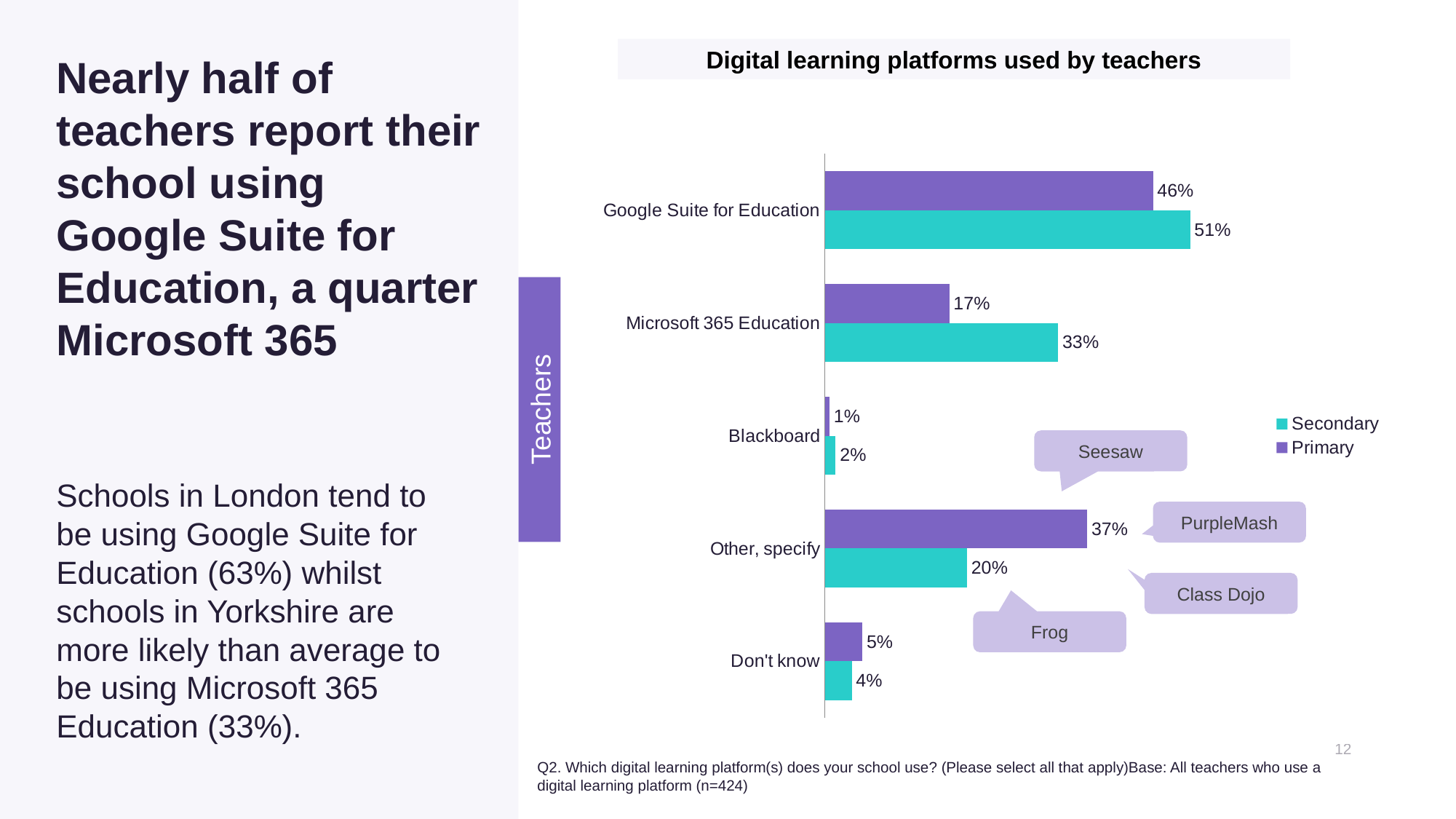
Which category has the lowest Primary value? Blackboard Which category has the highest Secondary value? Google Suite for Education For Other, specify, which series has the larger value, Primary or Secondary? Primary What is the Secondary value for Don't know? 4% What is the title of the chart? Digital learning platforms used by teachers What is the Primary value for Other, specify? 37% How many categories are shown on the chart? 5 What is the Secondary value for Microsoft 365 Education? 33% What kind of chart is shown on the slide? Bar chart What is the difference between the Secondary and Primary values for Microsoft 365 Education? 16% How many series does the legend list? 2 What is the Primary value for Google Suite for Education? 46%